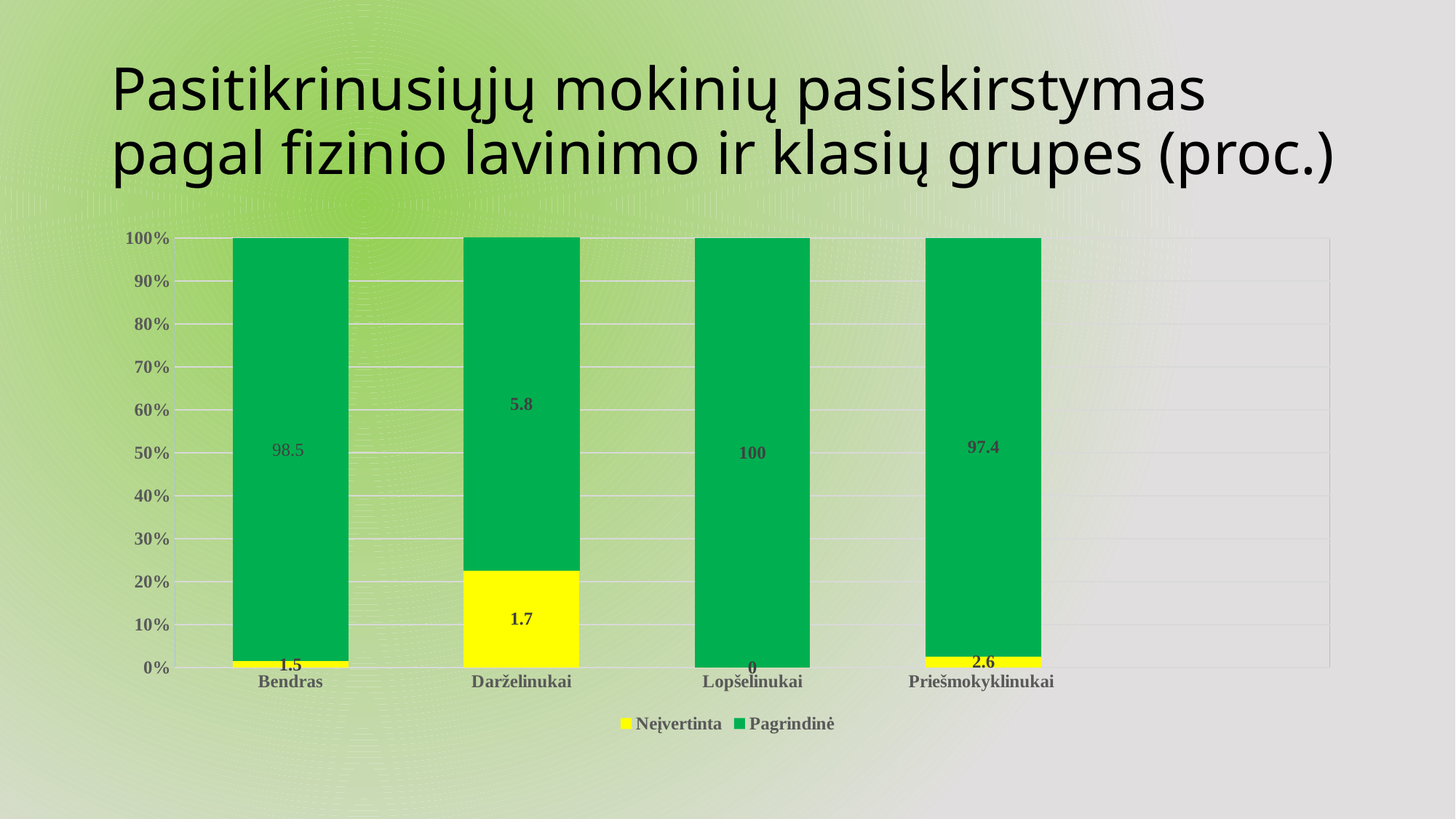
What is the Neįvertinta value for Darželinukai? 1.7 What is the Neįvertinta value for Priešmokyklinukai? 2.6 Which category has the highest Pagrindinė value? Lopšelinukai How many categories are shown on the x axis? 4 Which is larger, the Pagrindinė value for Bendras or for Priešmokyklinukai? Bendras What is the Pagrindinė value for Lopšelinukai? 100 How many series does the legend list? 2 Is the Neįvertinta segment for Darželinukai greater or less than 10% of the bar? greater What is the difference between the Pagrindinė and Neįvertinta values for Bendras? 97 Which category has the lowest Pagrindinė value? Darželinukai What is the Pagrindinė value for Bendras? 98.5 What kind of chart is shown on the slide? Stacked bar chart